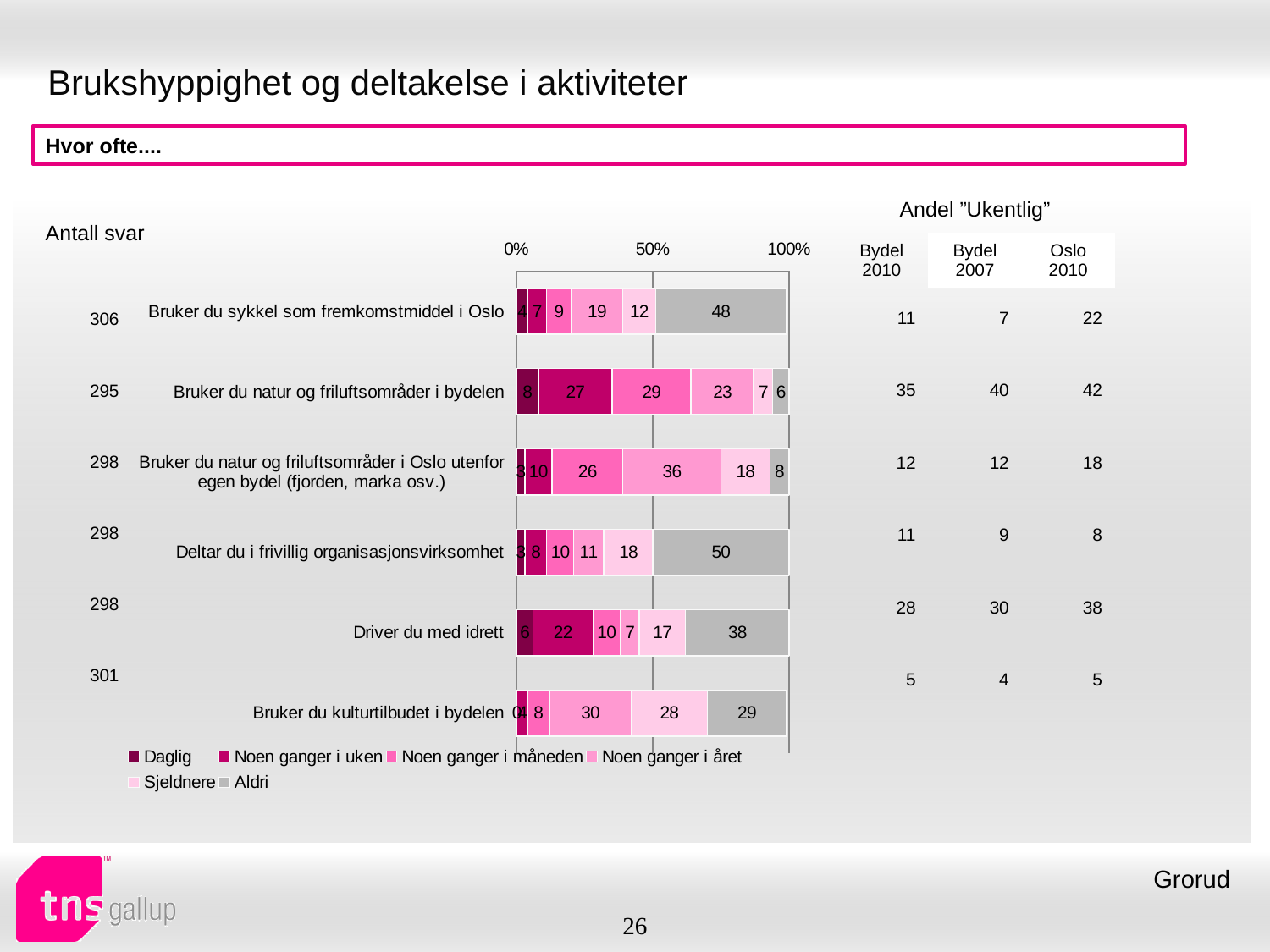
What is the value for "Noen ganger i året" in the bar for "Bruker du kulturtilbudet i bydelen"? 30 What is the value for "Aldri" in the bar for "Bruker du sykkel som fremkomstmiddel i Oslo"? 48 How many categories (questions) are shown in the chart? 6 Which category has the highest "Aldri" value? Deltar du i frivillig organisasjonsvirksomhet What is the difference between the "Aldri" values for "Bruker du sykkel som fremkomstmiddel i Oslo" and "Driver du med idrett"? 10 Which has the larger "Noen ganger i året" value: "Bruker du natur og friluftsområder i Oslo utenfor egen bydel" or "Bruker du kulturtilbudet i bydelen"? Bruker du natur og friluftsområder i Oslo utenfor egen bydel What kind of chart is shown on the slide? Stacked bar chart What is the first entry in the chart's legend? Daglig How many series does the legend list? 6 What is the value for "Sjeldnere" in the bar for "Driver du med idrett"? 17 Which category has the lowest "Aldri" value? Bruker du natur og friluftsområder i bydelen What is the value for "Noen ganger i uken" in the bar for "Bruker du natur og friluftsområder i bydelen"? 27